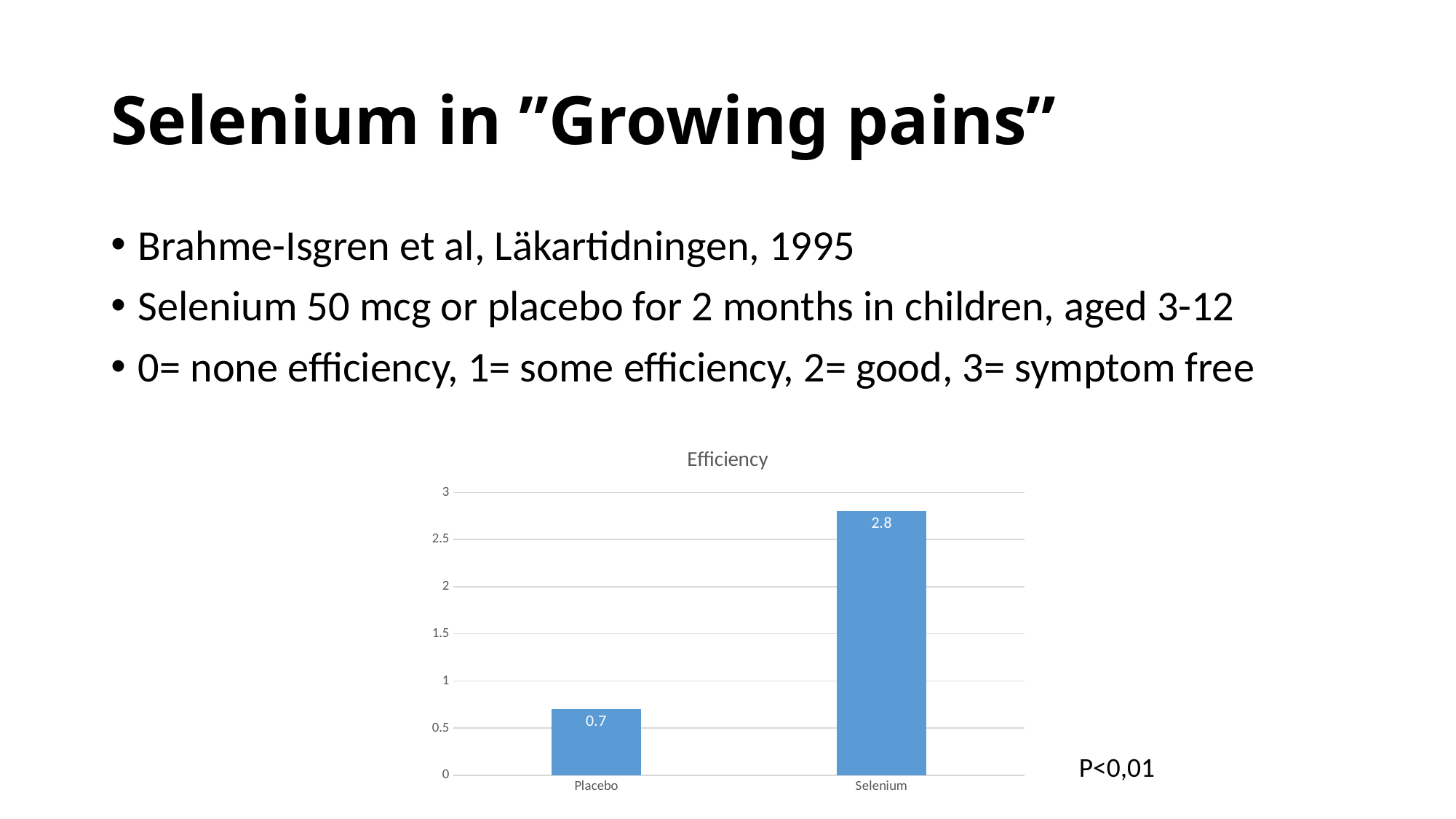
Which category has the highest value in the Efficiency chart? Selenium How many categories are shown in the Efficiency chart? 2 What is the difference between the Selenium and Placebo values in the Efficiency chart? 2.1 Which is larger in the Efficiency chart, the value for Placebo or the value for Selenium? Selenium Is the value for Placebo in the Efficiency chart greater or less than 1? less Is the value for Selenium in the Efficiency chart greater or less than 2.5? greater What is the maximum value shown on the y axis of the Efficiency chart? 3 What is the value for Selenium in the Efficiency chart? 2.8 Which category has the lowest value in the Efficiency chart? Placebo What is the title of the chart on the slide? Efficiency What is the value for Placebo in the Efficiency chart? 0.7 What kind of chart is shown on the slide? bar chart